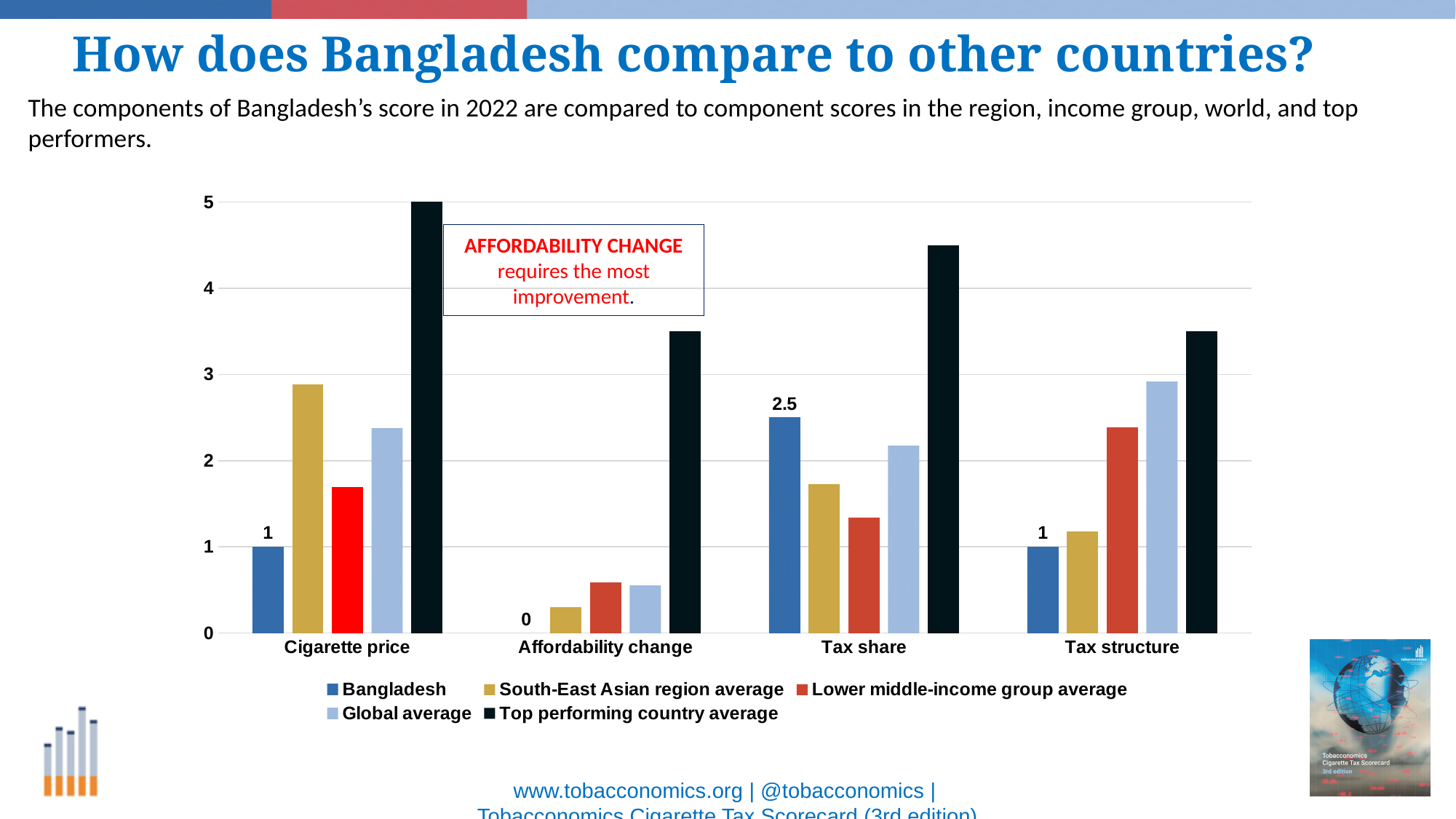
For Tax share, which is larger: Bangladesh or the Global average? Bangladesh What is Bangladesh's score for Cigarette price? 1 In which component does Bangladesh have its highest score? Tax share What is the difference between Bangladesh's Tax share score and its Cigarette price score? 1.5 In which component does Bangladesh have its lowest score? Affordability change What is the Top performing country average for Cigarette price? 5 Is the Global average for Tax structure greater or less than 2? greater How many series does the legend list? 5 Which series is shown in black? Top performing country average What is Bangladesh's score for Tax structure? 1 What is Bangladesh's score for Affordability change? 0 What is Bangladesh's score for Tax share? 2.5